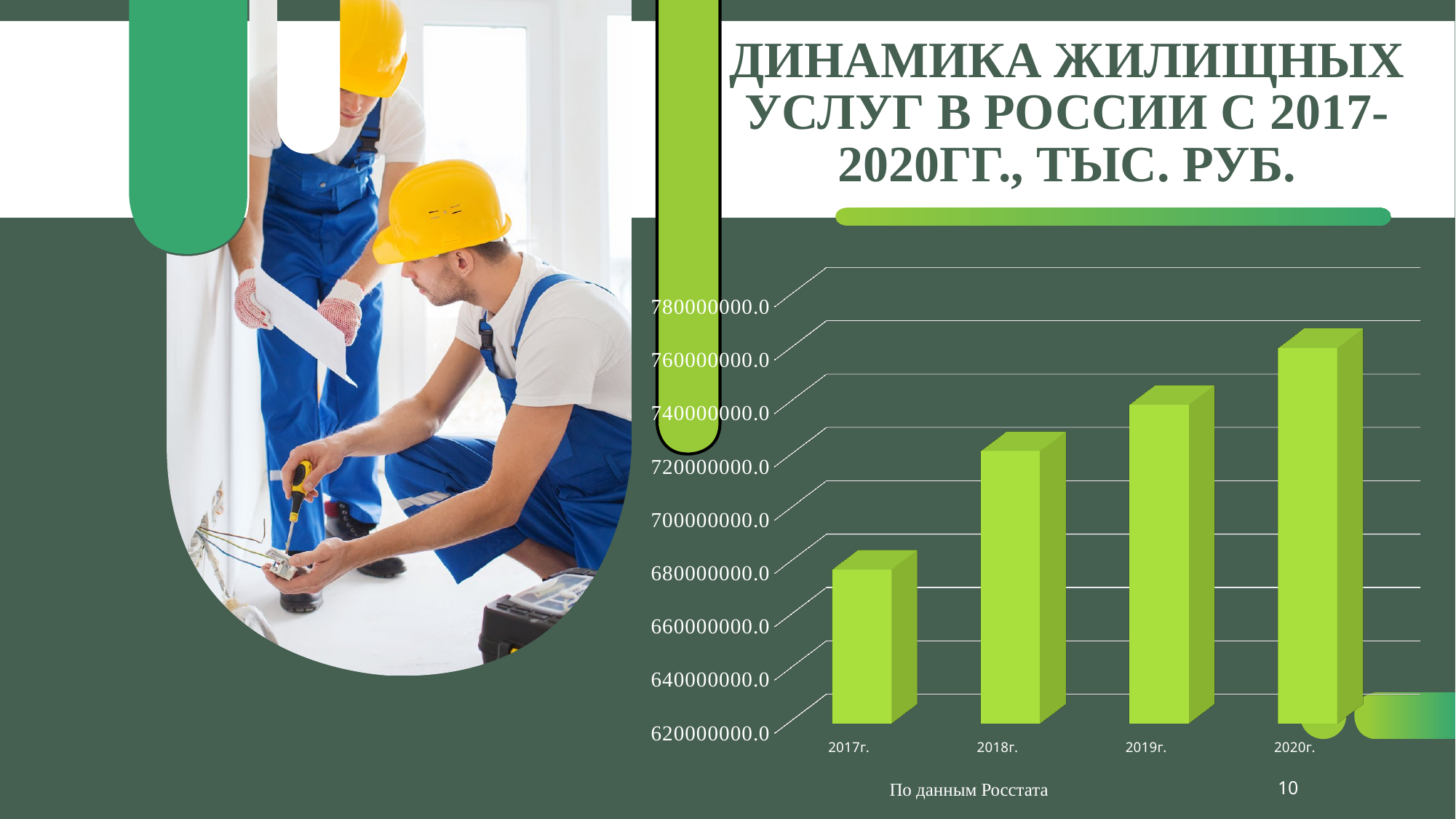
Which year has the lowest value on the chart? 2017г. Which year has the highest value on the chart? 2020г. What is the title of the chart on the slide? ДИНАМИКА ЖИЛИЩНЫХ УСЛУГ В РОССИИ С 2017-2020ГГ., ТЫС. РУБ. Is the value for 2020г. greater or less than 740000000.0? greater Is the value for 2017г. greater or less than 700000000.0? less Is the value for 2020г. greater or less than 780000000.0? less Which is larger, the value for 2018г. or the value for 2019г.? 2019г. What kind of chart is shown on the slide? Bar chart How many years (categories) are plotted on the chart? 4 Do the values rise or fall from 2017г. to 2020г.? Rise